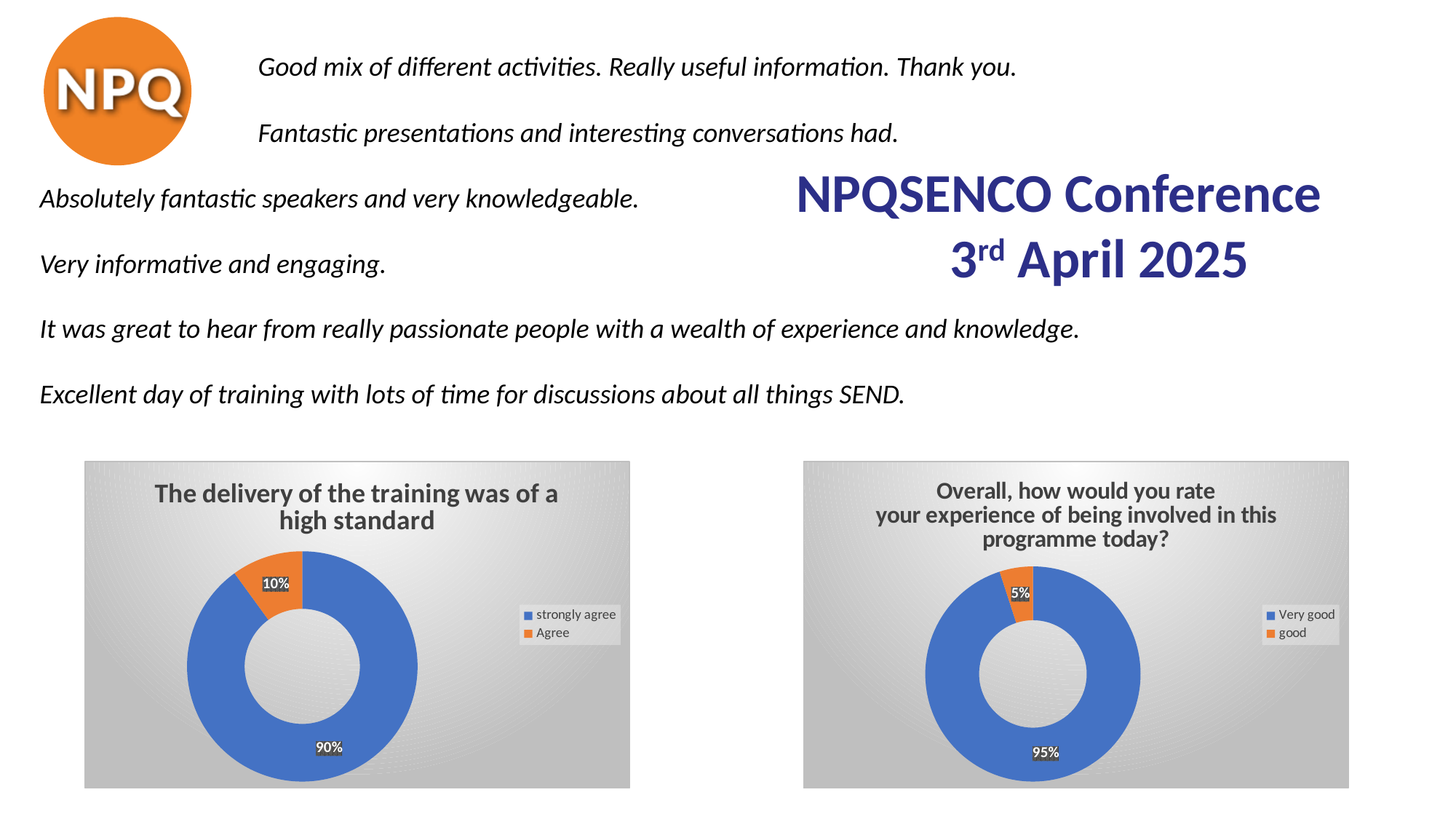
In the chart titled 'Overall, how would you rate your experience of being involved in this programme today?', what percentage of respondents chose 'Very good'? 95% Which is larger: the 'Agree' share in the left chart or the 'good' share in the right chart? Agree (left chart) In the chart on the right, what is the difference in percentage points between 'Very good' and 'good'? 90 In the chart on the left, what colour represents 'Agree'? Orange In the chart titled 'Overall, how would you rate your experience of being involved in this programme today?', what percentage of respondents chose 'good'? 5% In the chart titled 'The delivery of the training was of a high standard', what is the difference in percentage points between 'strongly agree' and 'Agree'? 80 In the chart titled 'The delivery of the training was of a high standard', what percentage of respondents chose 'strongly agree'? 90% How many categories does the legend of the chart on the right list? 2 In the chart on the left, which response category has the largest share? strongly agree In the chart titled 'The delivery of the training was of a high standard', what percentage of respondents chose 'Agree'? 10% In the chart on the right, which response category has the smallest share? good What type of chart is used on the left of the slide? Doughnut chart